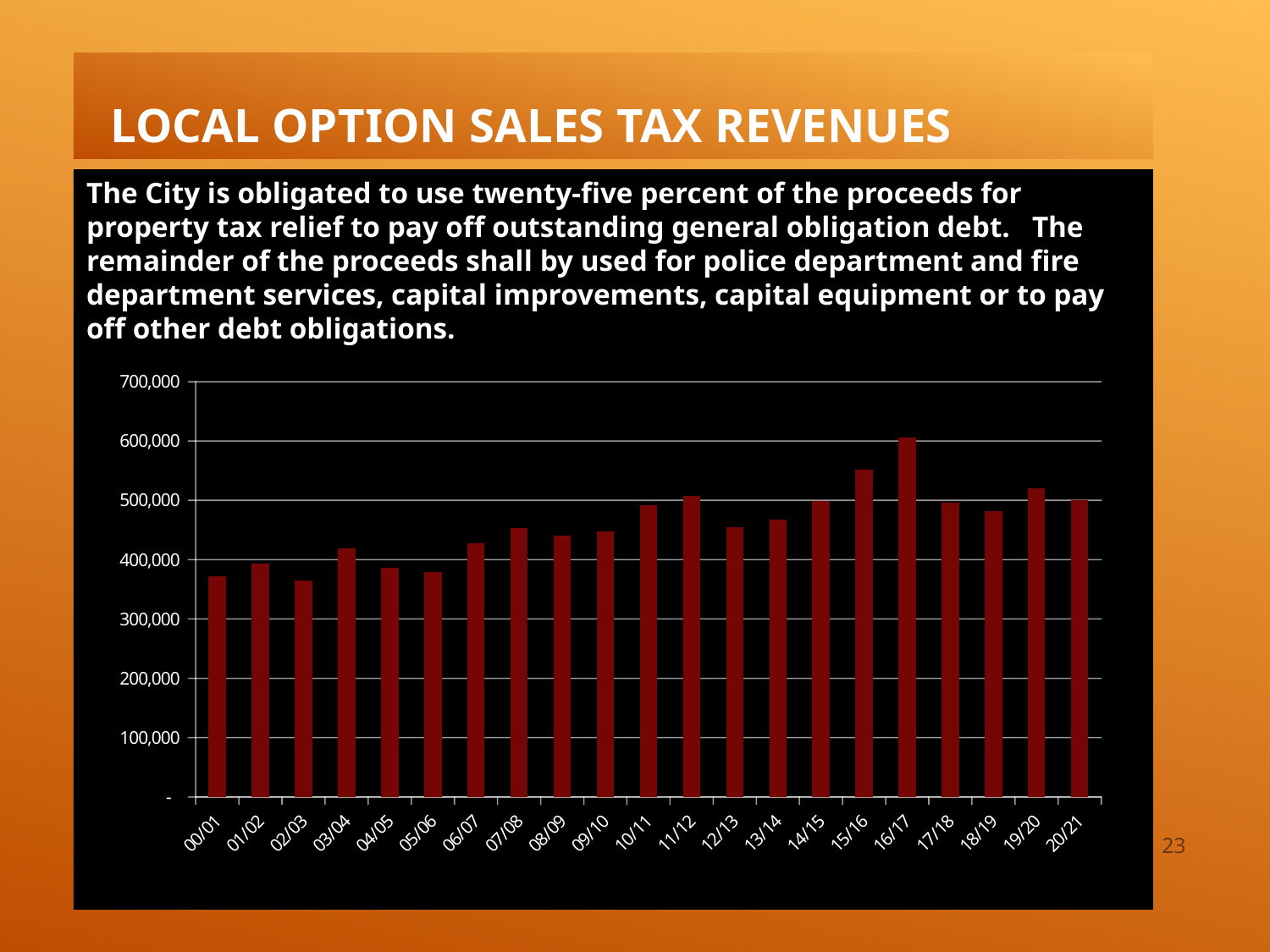
Is the value for 02/03 greater or less than 400,000? less Is the value for 00/01 greater or less than 400,000? less Which is larger, the value for 11/12 or the value for 12/13? 11/12 Is the value for 12/13 greater or less than 500,000? less Do the values rise or fall from 16/17 to 18/19? fall What is the title of the slide containing the chart? LOCAL OPTION SALES TAX REVENUES Which is larger, the value for 15/16 or the value for 14/15? 15/16 Which fiscal year has the highest local option sales tax revenue? 16/17 How many fiscal years (bars) are plotted on the chart? 21 What kind of chart is shown on the slide? Bar chart